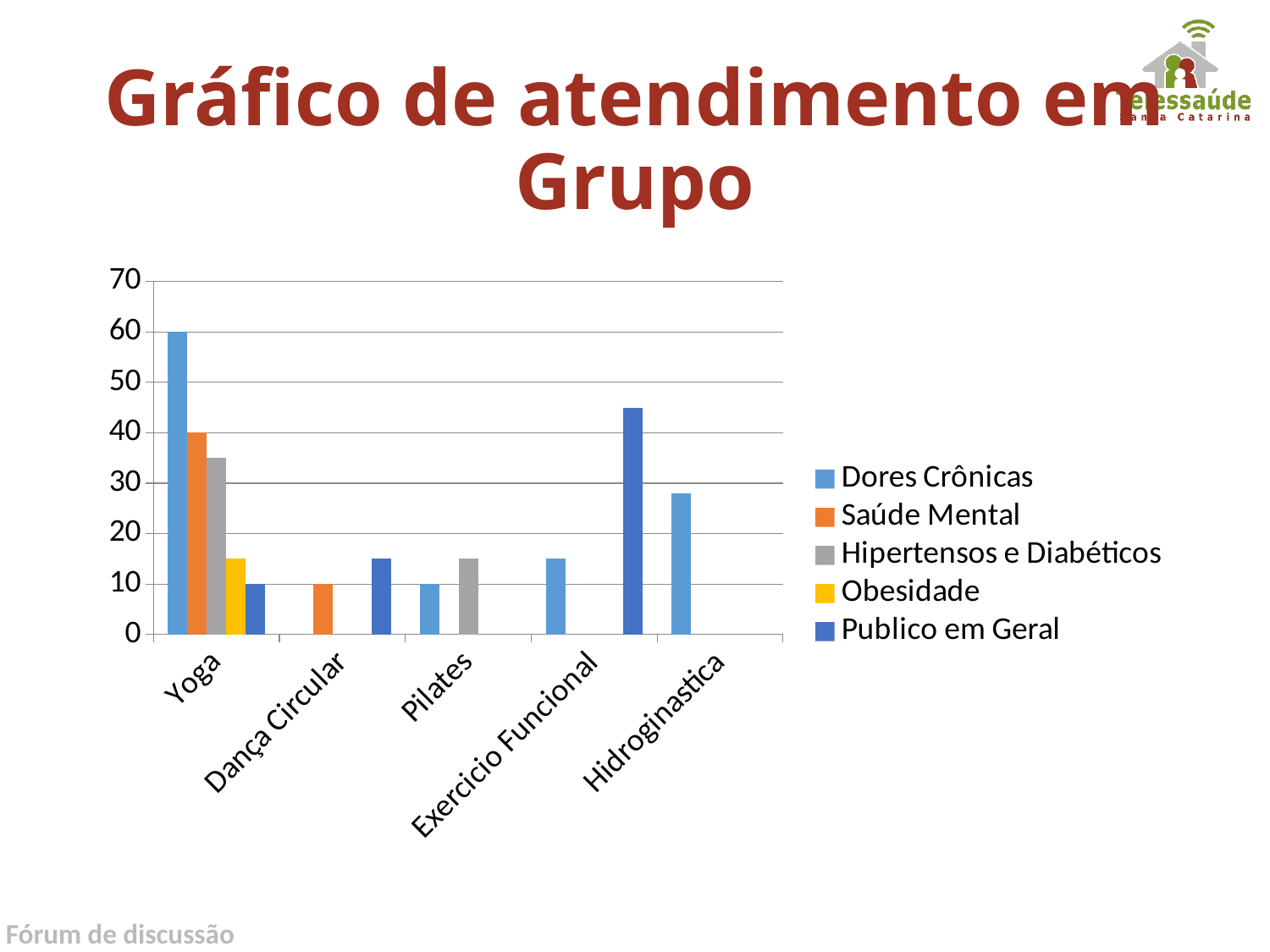
What is the difference between Dores Crônicas and Saúde Mental for Yoga? 20 What is the value of Saúde Mental for Yoga? 40 What kind of chart is shown on the slide? bar chart Is the value of Dores Crônicas for Hidroginastica greater or less than 20? greater How many categories are shown on the x axis of the chart? 5 Which category has the highest Dores Crônicas bar? Yoga How many series does the chart legend list? 5 Is the value of Hipertensos e Diabéticos for Yoga greater or less than 30? greater Which is larger: Dores Crônicas for Yoga or Publico em Geral for Exercicio Funcional? Dores Crônicas for Yoga Is the value of Publico em Geral for Exercicio Funcional greater or less than 40? greater What is the value of Dores Crônicas for Yoga? 60 What is the value of Publico em Geral for Yoga? 10